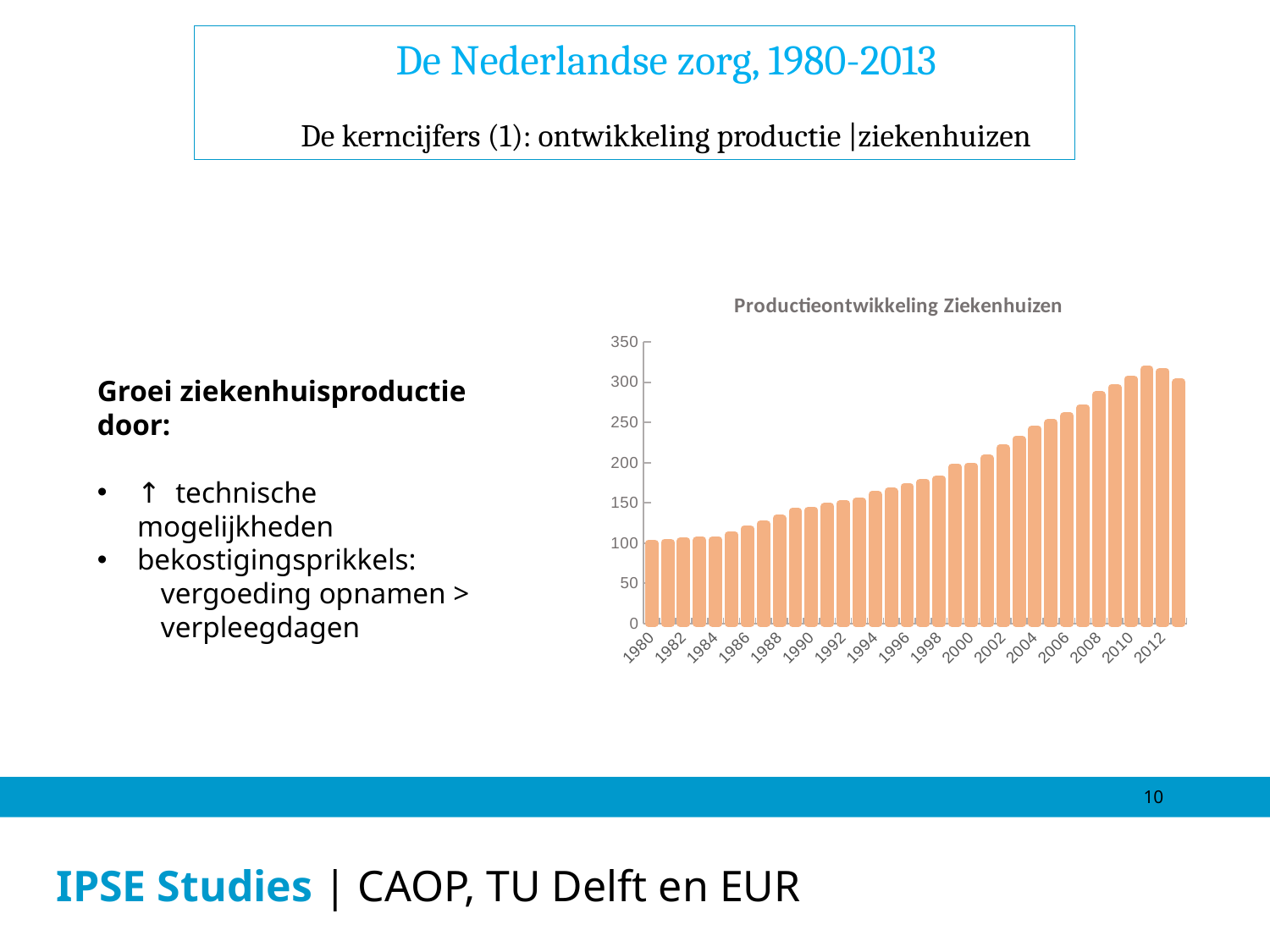
Which year has the larger value, 1990 or 2010? 2010 Is the value for 1984 greater or less than 150? less What is the title of the chart? Productieontwikkeling Ziekenhuizen Is the value for 1988 greater or less than 100? greater What type of chart is shown on the slide? bar chart Is the value for 1996 greater or less than 150? greater What is the highest value shown on the vertical axis of the chart? 350 Which year has the larger value, 1996 or 2006? 2006 Do the values in the chart generally rise or fall from 1980 to 2013? rise